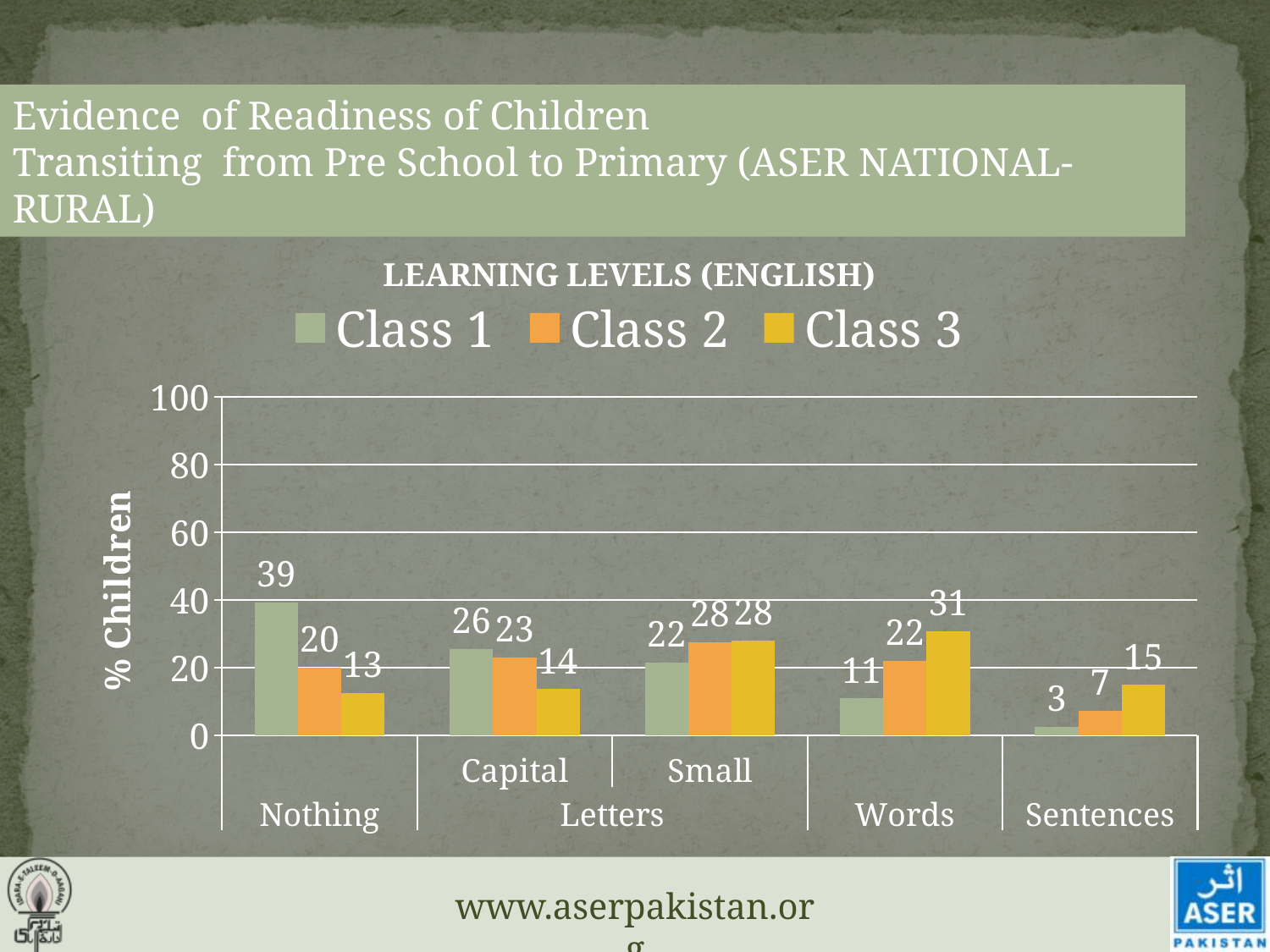
What is the value for Class 3 in the Words category? 31 What kind of chart is shown on the slide? bar chart What is the title of the chart? LEARNING LEVELS (ENGLISH) How many categories are shown on the x axis? 5 Which is larger in the Words category: Class 1 or Class 2? Class 2 Which category has the highest value for Class 1? Nothing Is the value for Class 1 in the Nothing category greater or less than 20? greater What is the difference between the Class 1 and Class 3 values in the Nothing category? 26 What is the value for Class 1 in the Nothing category? 39 How many series does the legend list? 3 Which category has the lowest value for Class 3? Nothing What is the value for Class 2 in the Sentences category? 7